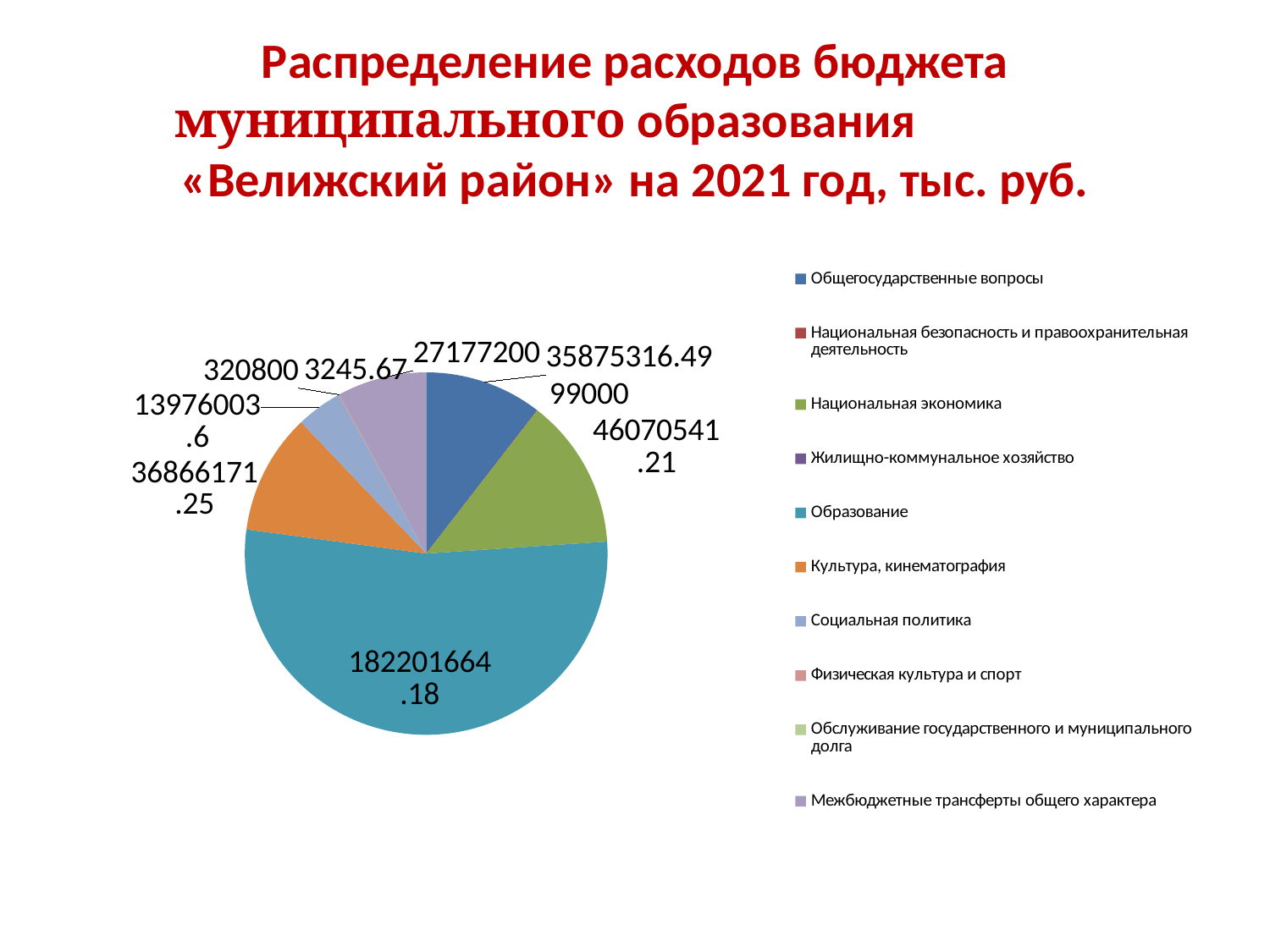
What is the value shown for Образование? 182201664.18 What is the value shown for Национальная экономика? 46070541.21 How many categories does the legend of the pie chart list? 10 What is the value shown for Культура, кинематография? 36866171.25 What type of chart is shown on the slide? pie chart What is the difference between the values for Образование and Национальная экономика? 136131122.97 What is the value shown for Социальная политика? 13976003.6 Which category has the largest slice of the pie chart? Образование Which is larger, the value for Национальная экономика or the value for Общегосударственные вопросы? Национальная экономика What is the value shown for Общегосударственные вопросы? 35875316.49 What colour is the slice for Образование in the pie chart? teal What is the difference between the values for Национальная экономика and Общегосударственные вопросы? 10195224.72